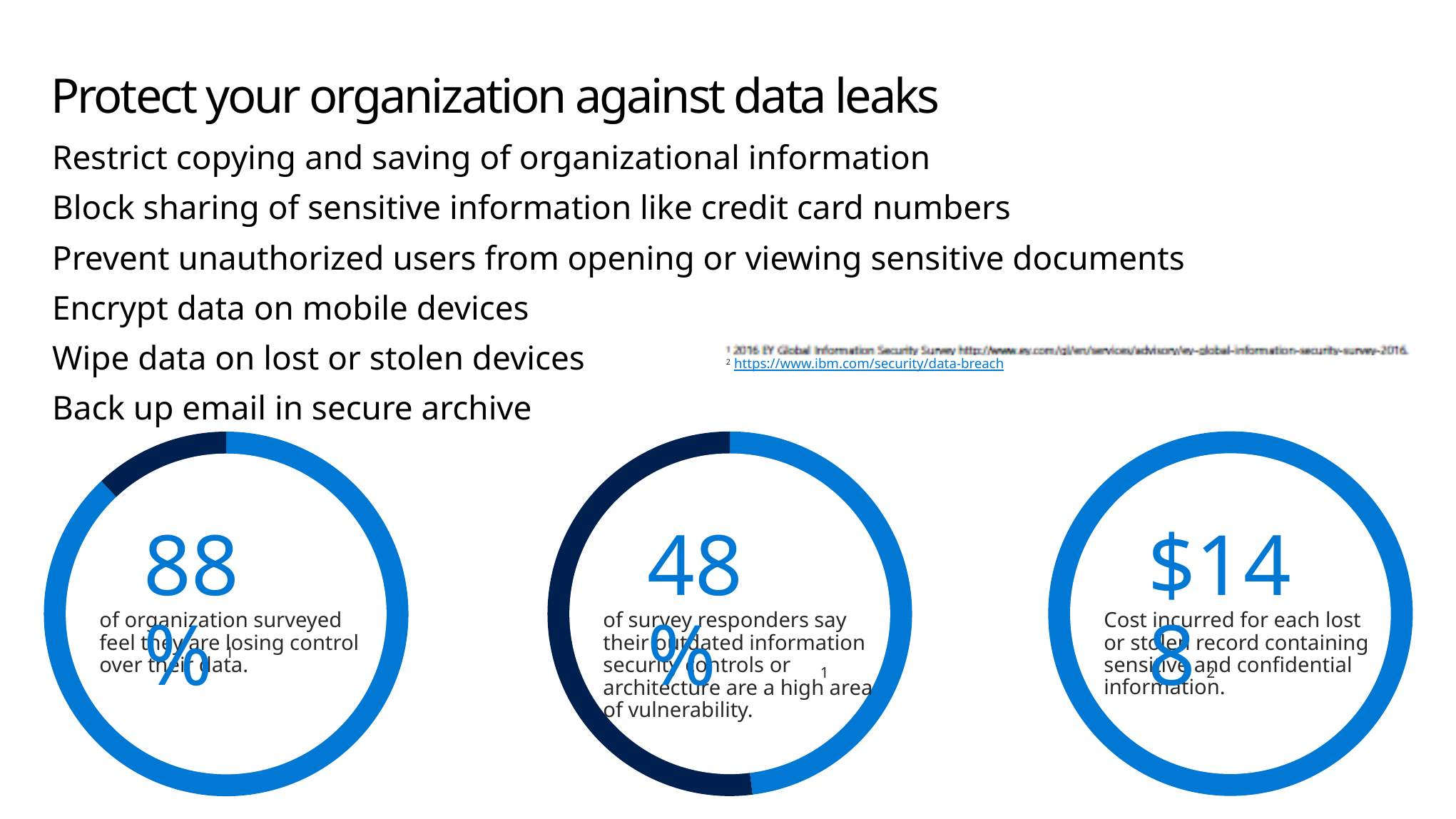
Is the percentage shown in the left donut chart greater or less than 80%? greater What is the difference between the percentage shown in the left donut chart and the percentage shown in the middle donut chart? 40 percentage points What kind of chart is used for the three figures at the bottom of the slide? Donut (ring) chart How many donut charts are shown on the slide? 3 Which is larger: the percentage in the left donut chart or the percentage in the middle donut chart? The left donut chart (88%) In the left donut chart, what percentage of organizations surveyed feel they are losing control over their data? 88% Is the percentage shown in the middle donut chart greater or less than 50%? less In the middle donut chart, what percentage of survey responders say their outdated information security controls or architecture are a high area of vulnerability? 48% In the right donut chart, what is the cost incurred for each lost or stolen record containing sensitive and confidential information? $148 Which of the three donut charts has its ring filled entirely in a single colour? The right donut chart ($148) In the left donut chart, which colour fills the larger portion of the ring? Light blue